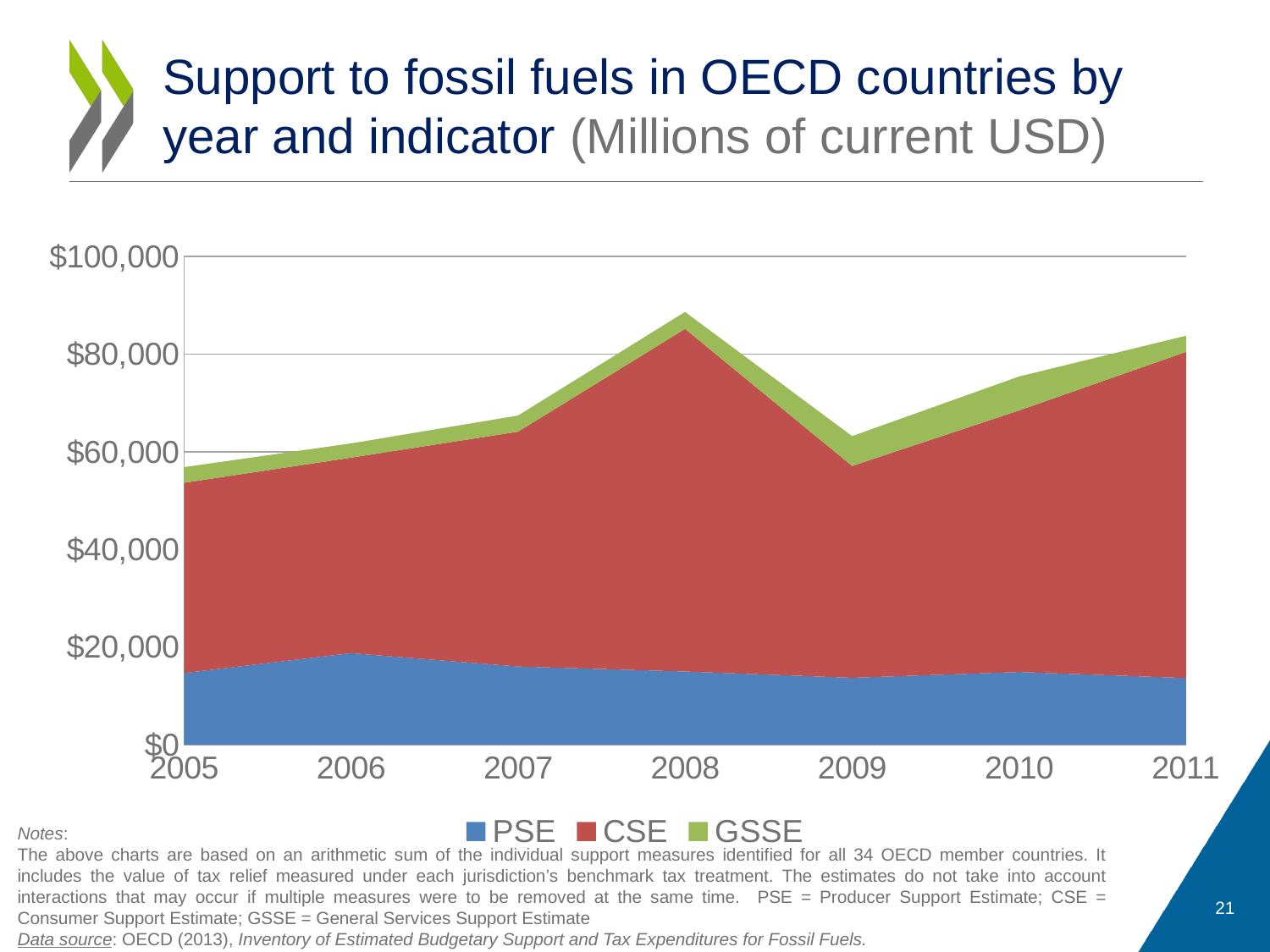
What kind of chart is shown on the slide? Stacked area chart In which year is the total support to fossil fuels lowest? 2005 Which series accounts for the largest share of support in every year, PSE or CSE? CSE What unit is stated in the chart's title? Millions of current USD How many years are shown along the x axis of the chart? 7 In which year is the total support to fossil fuels highest? 2008 Is the total support in 2007 greater or less than $60,000? greater Is the total support in 2005 greater or less than $60,000? less What are the three series named in the chart's legend? PSE, CSE, GSSE Is the total support in 2008 greater or less than $80,000? greater How many series does the chart's legend list? 3